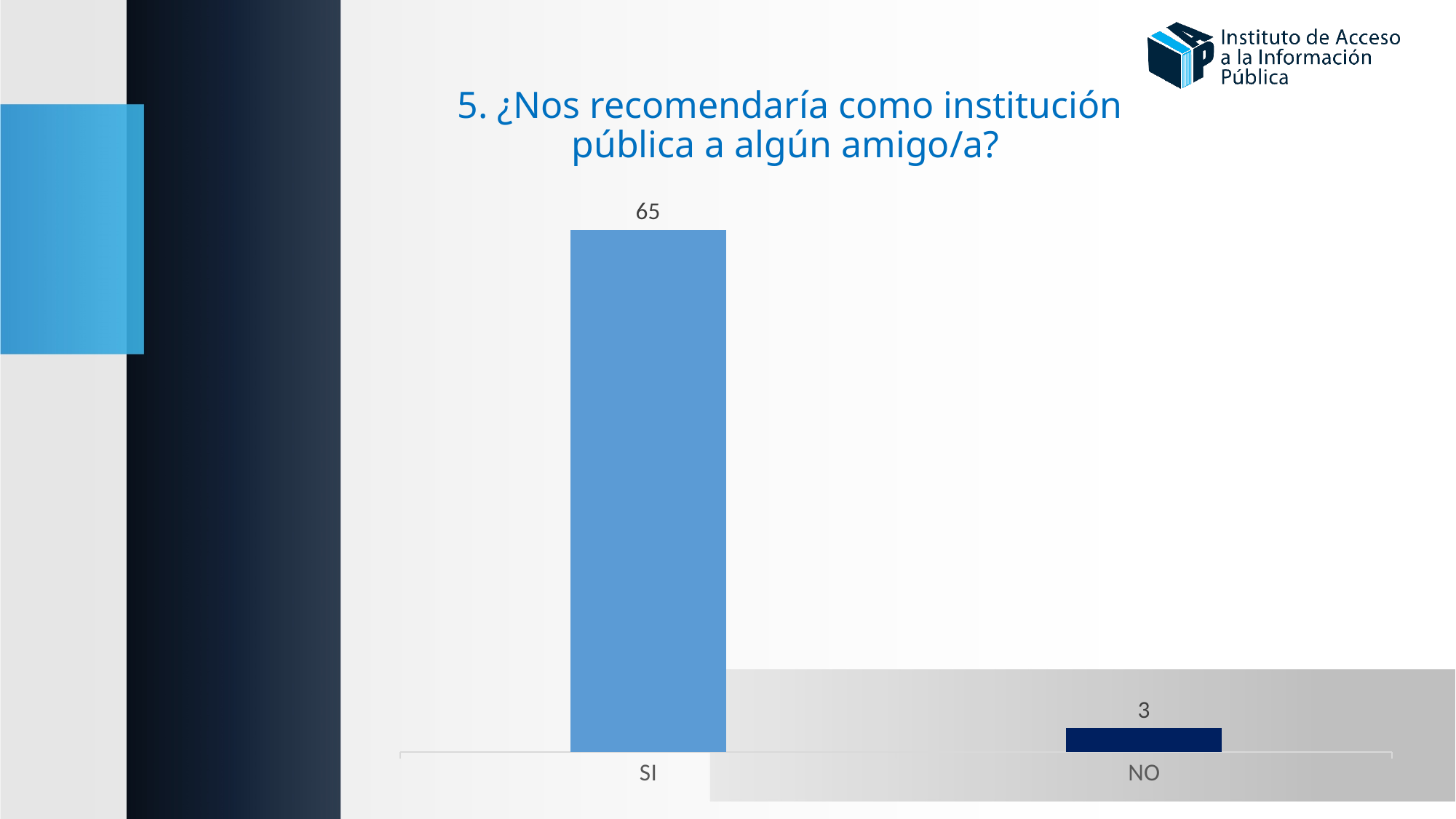
Which is larger, the value for SI or the value for NO? SI What is the total of the values for SI and NO? 68 What is the title of the chart? 5. ¿Nos recomendaría como institución pública a algún amigo/a? What is the value for SI? 65 How many categories are shown in the chart? 2 Which category has the highest value? SI What is the value for NO? 3 What is the difference between the values for SI and NO? 62 What colour is the bar for NO? Dark navy blue Which category has the lowest value? NO What kind of chart is shown on the slide? Bar chart